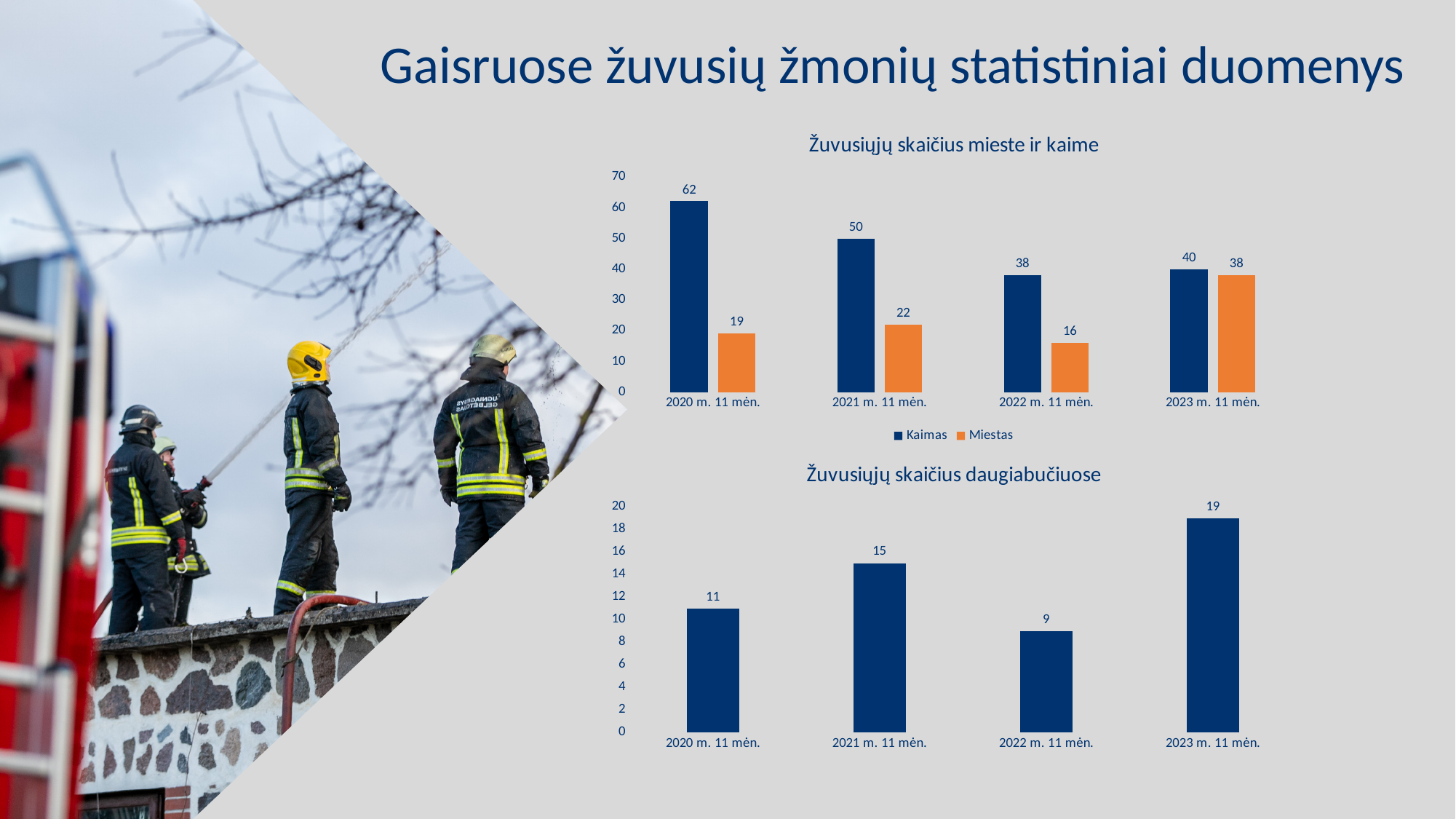
In the chart titled 'Žuvusiųjų skaičius daugiabučiuose', what is the difference between the values for 2023 m. 11 mėn. and 2020 m. 11 mėn.? 8 In the chart titled 'Žuvusiųjų skaičius daugiabučiuose', which period has the lowest value? 2022 m. 11 mėn. In the chart titled 'Žuvusiųjų skaičius mieste ir kaime', how many series does the legend list? 2 In the chart titled 'Žuvusiųjų skaičius mieste ir kaime', what is the Kaimas value for 2020 m. 11 mėn.? 62 In the chart titled 'Žuvusiųjų skaičius mieste ir kaime', does the Kaimas value rise or fall from 2020 m. 11 mėn. to 2022 m. 11 mėn.? fall In the chart titled 'Žuvusiųjų skaičius mieste ir kaime', what is the Miestas value for 2022 m. 11 mėn.? 16 What kind of chart is the chart titled 'Žuvusiųjų skaičius daugiabučiuose'? bar chart In the chart titled 'Žuvusiųjų skaičius mieste ir kaime', which period has the highest Kaimas value? 2020 m. 11 mėn. In the chart titled 'Žuvusiųjų skaičius daugiabučiuose', how many periods are shown on the x axis? 4 In the chart titled 'Žuvusiųjų skaičius mieste ir kaime', what is the difference between the Kaimas and Miestas values for 2021 m. 11 mėn.? 28 In the chart titled 'Žuvusiųjų skaičius mieste ir kaime', which period has the lowest Miestas value? 2022 m. 11 mėn. In the chart titled 'Žuvusiųjų skaičius daugiabučiuose', what is the value for 2023 m. 11 mėn.? 19